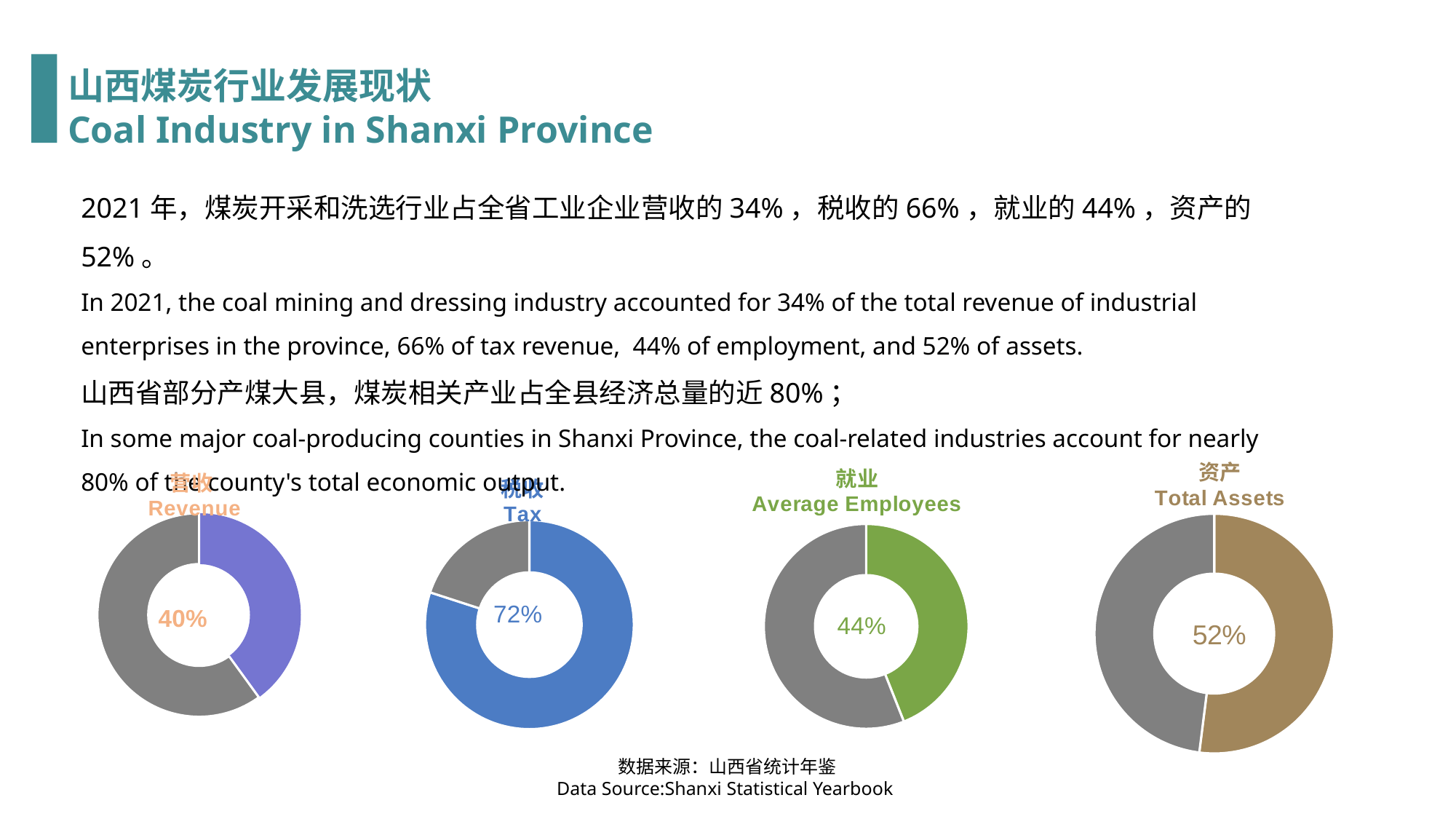
Which of the four donut charts shows the lowest percentage? Revenue What percentage is shown in the centre of the Revenue donut chart? 40% What type of chart is used to show the Revenue share? Donut (pie) chart What percentage is shown in the centre of the Tax donut chart? 72% In the Tax donut chart, what share of the ring is coloured blue? 72% How many donut charts are shown on the slide? 4 What colour is the highlighted segment in the Average Employees donut chart? Green Which is larger, the percentage in the Total Assets chart or the percentage in the Average Employees chart? Total Assets What percentage is shown in the centre of the Average Employees donut chart? 44% Which of the four donut charts shows the highest percentage? Tax What is the difference between the percentage in the Tax chart and the percentage in the Revenue chart? 32% What percentage is shown in the centre of the Total Assets donut chart? 52%